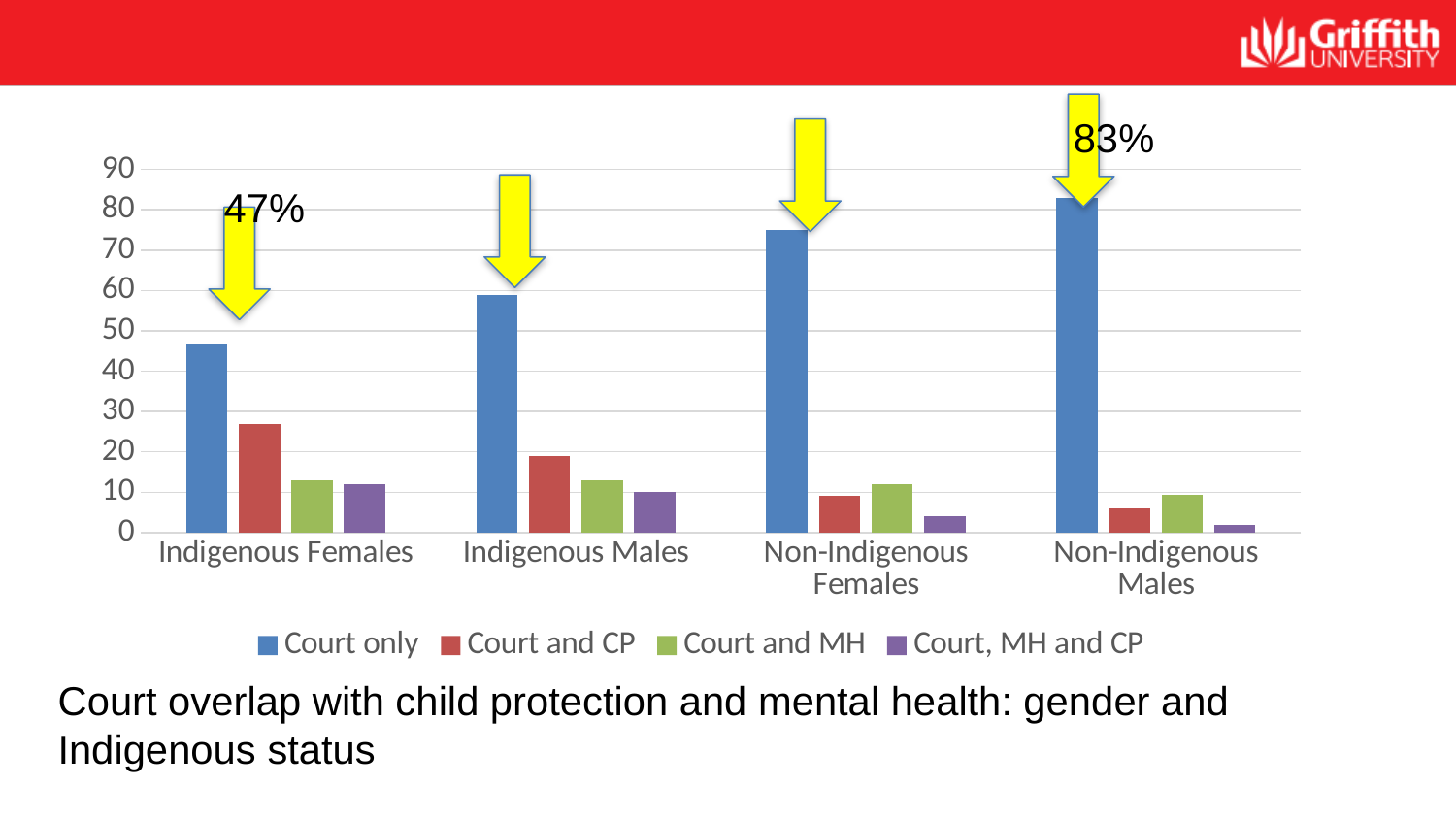
Which category has the lowest Court only bar? Indigenous Females How many categories are shown on the x axis of the chart? 4 What is the Court only value for Indigenous Females, as annotated on the chart? 47% Is the Court only value for Indigenous Males greater or less than 50? greater What kind of chart is shown on the slide? bar chart Do the Court only values rise or fall moving from Indigenous Females to Non-Indigenous Males along the x axis? rise How many series does the chart's legend list? 4 What is the difference between the annotated Court only values for Non-Indigenous Males and Indigenous Females? 36 percentage points Which category has the highest Court only bar? Non-Indigenous Males Which is larger: the Court and CP value for Indigenous Females or for Indigenous Males? Indigenous Females What is the Court only value for Non-Indigenous Males, as annotated on the chart? 83% Which series has the smallest bar for Non-Indigenous Males? Court, MH and CP